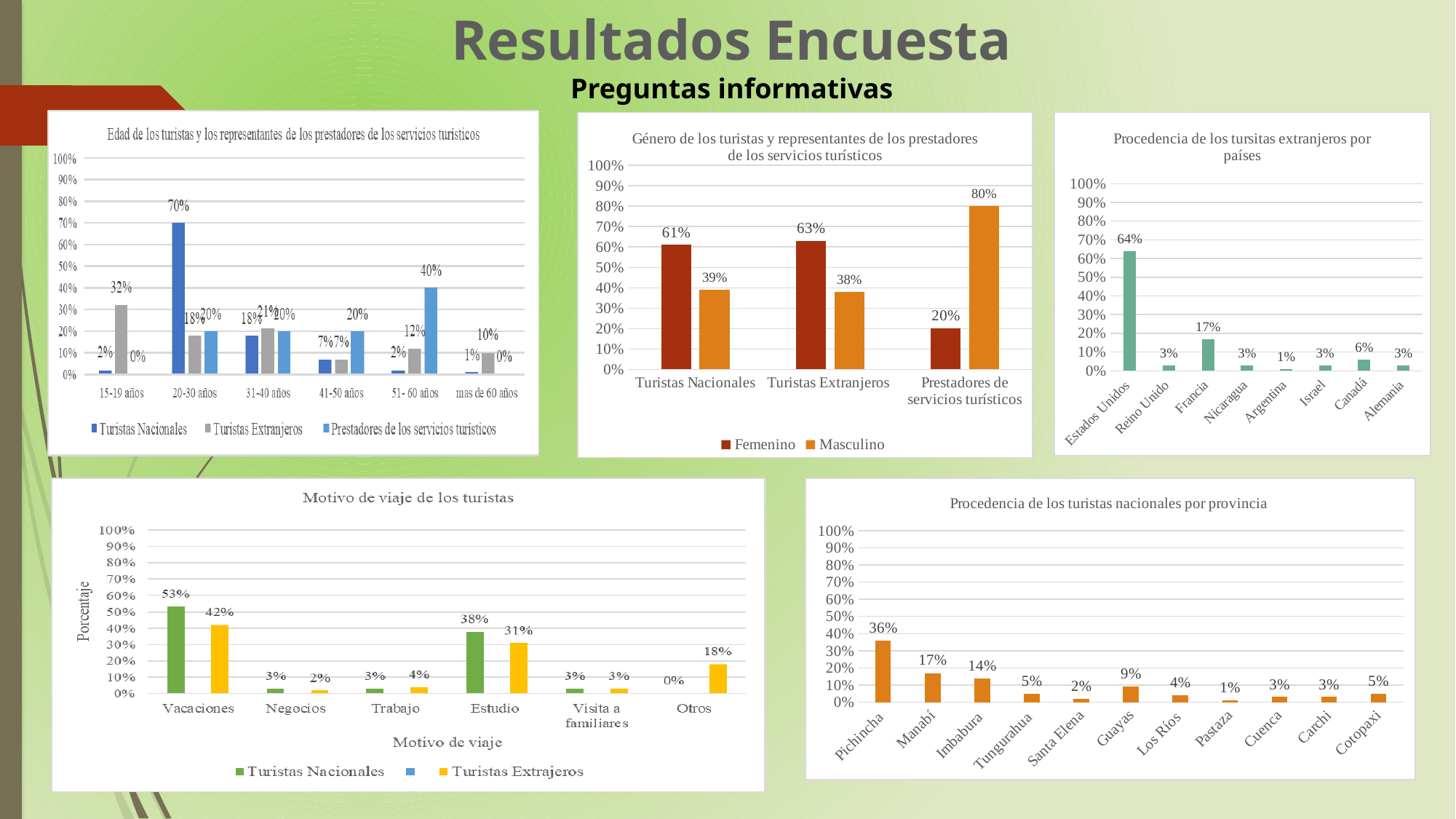
In the chart 'Motivo de viaje de los turistas', which is larger for Estudio: Turistas Nacionales or Turistas Extrajeros? Turistas Nacionales In the chart 'Motivo de viaje de los turistas', what is the Turistas Extrajeros value for Otros? 18% In the chart 'Procedencia de los turistas nacionales por provincia', what is the value for Guayas? 9% In the chart 'Edad de los turistas y los representantes de los prestadores de los servicios turísticos', what is the Turistas Nacionales value for 20-30 años? 70% In the chart 'Género de los turistas y representantes de los prestadores de los servicios turísticos', what is the difference between the Femenino and Masculino values for Turistas Nacionales? 22% How many countries are shown in the chart 'Procedencia de los tursitas extranjeros por países'? 8 How many series does the legend list in the chart 'Edad de los turistas y los representantes de los prestadores de los servicios turísticos'? 3 How many provinces are shown in the chart 'Procedencia de los turistas nacionales por provincia'? 11 In the chart 'Procedencia de los turistas nacionales por provincia', which province has the lowest value? Pastaza In the chart 'Género de los turistas y representantes de los prestadores de los servicios turísticos', what is the Masculino value for Prestadores de servicios turísticos? 80% In the chart 'Procedencia de los tursitas extranjeros por países', which country has the highest value? Estados Unidos In the chart 'Procedencia de los tursitas extranjeros por países', what is the value for Francia? 17%